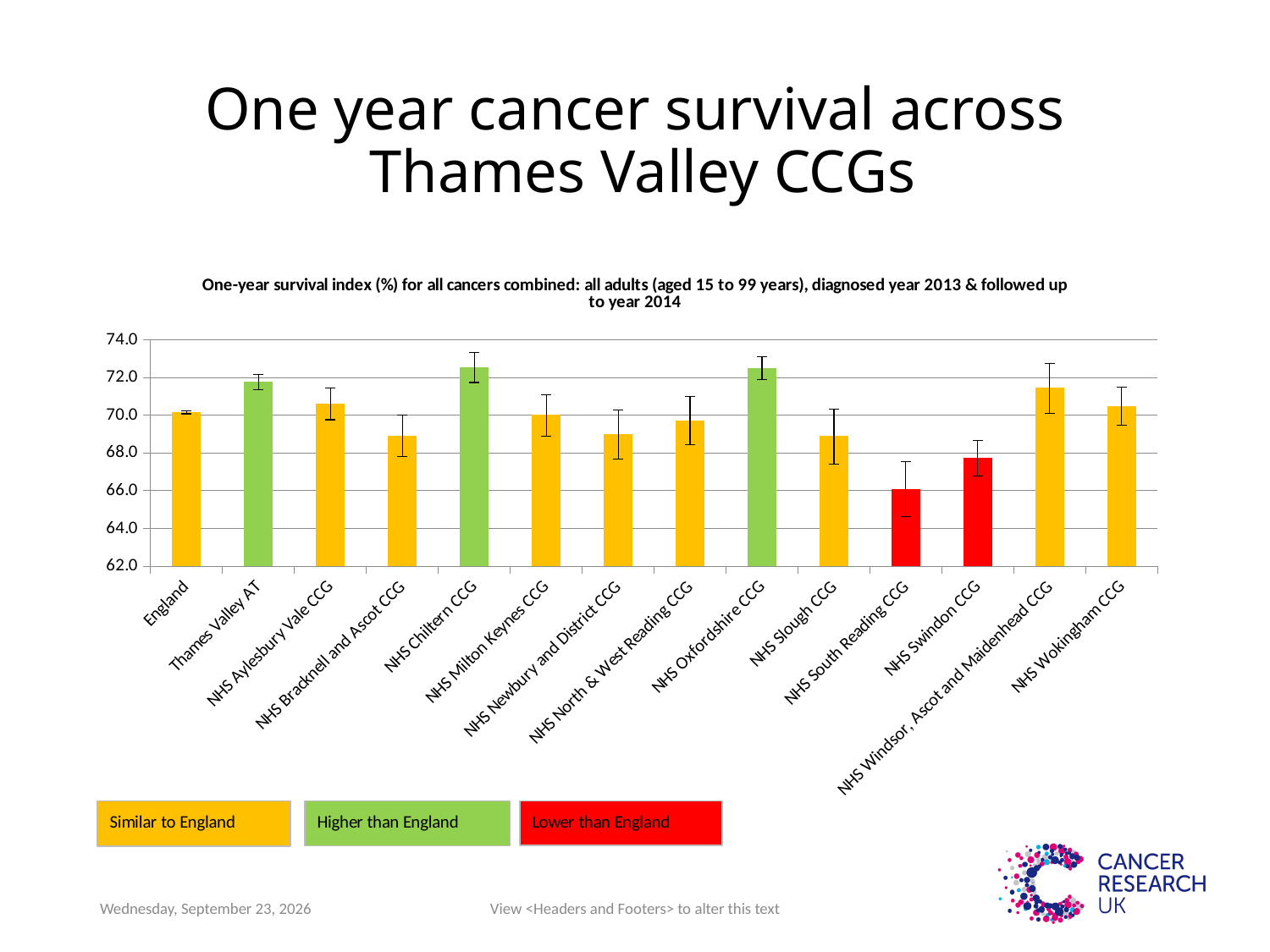
Is the value for Thames Valley AT greater or less than 70.0? greater Is the value for NHS Chiltern CCG greater or less than 72.0? greater What kind of chart is shown on the slide? bar chart Which category has the lowest one-year survival index in the chart? NHS South Reading CCG Is the value for NHS Bracknell and Ascot CCG greater or less than 70.0? less According to the colour key below the chart, what does a red bar indicate? Lower than England How many categories are plotted along the x axis of the chart? 14 How many bars in the chart are coloured green (higher than England)? 3 Which has the higher one-year survival index, NHS Chiltern CCG or NHS Slough CCG? NHS Chiltern CCG Which has the higher one-year survival index, NHS Swindon CCG or NHS Wokingham CCG? NHS Wokingham CCG